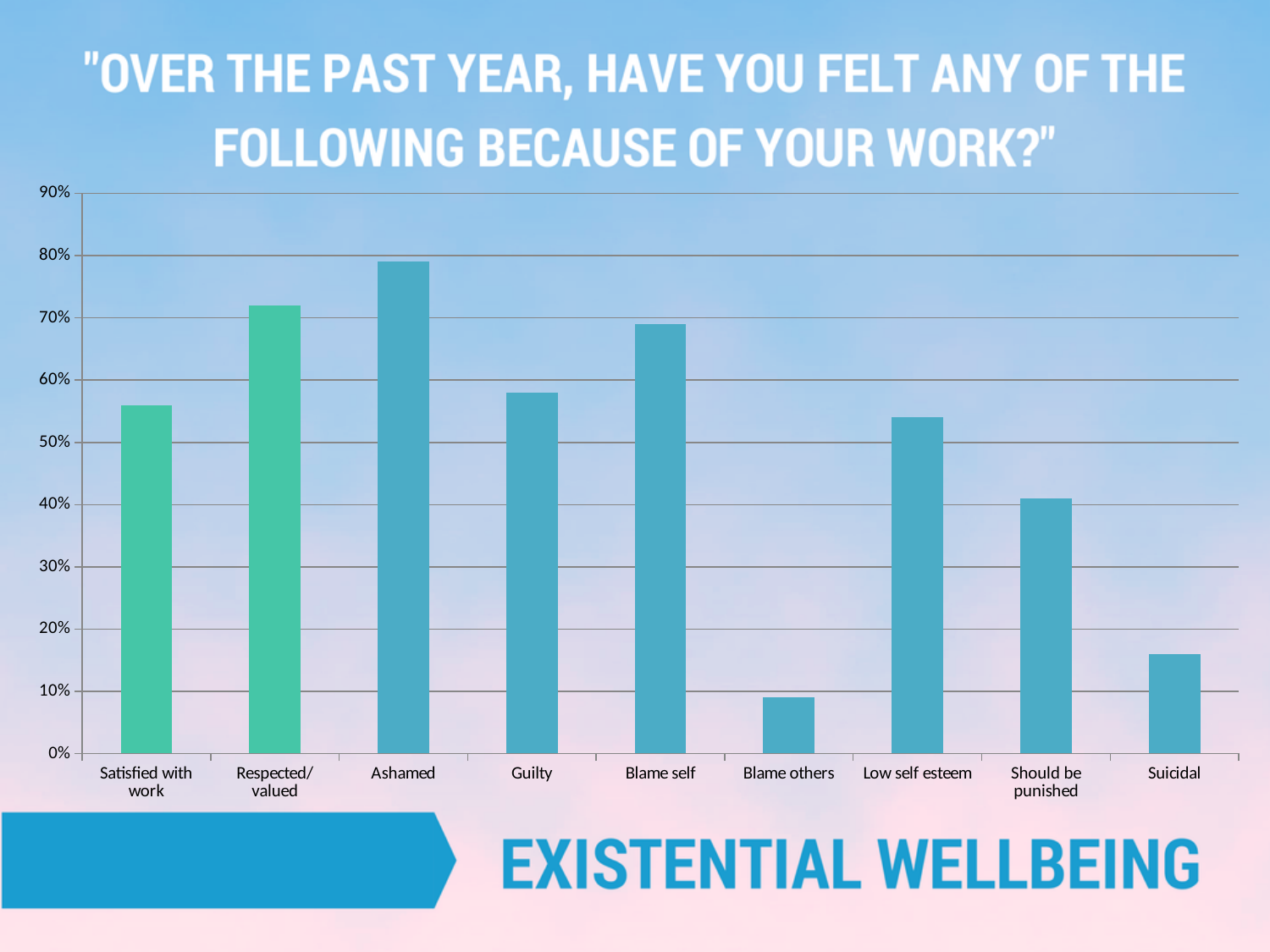
Which is larger, the value for Should be punished or the value for Suicidal? Should be punished Is the value for Blame others greater or less than 20%? less How many categories are plotted on the chart? 9 What kind of chart is shown on the slide? Bar chart Which category has the lowest value? Blame others Which is larger, the value for Ashamed or the value for Blame self? Ashamed Which category has the highest value? Ashamed Is the value for Should be punished greater or less than 50%? less What is the title of the chart? "Over the past year, have you felt any of the following because of your work?" Is the value for Satisfied with work greater or less than 50%? greater